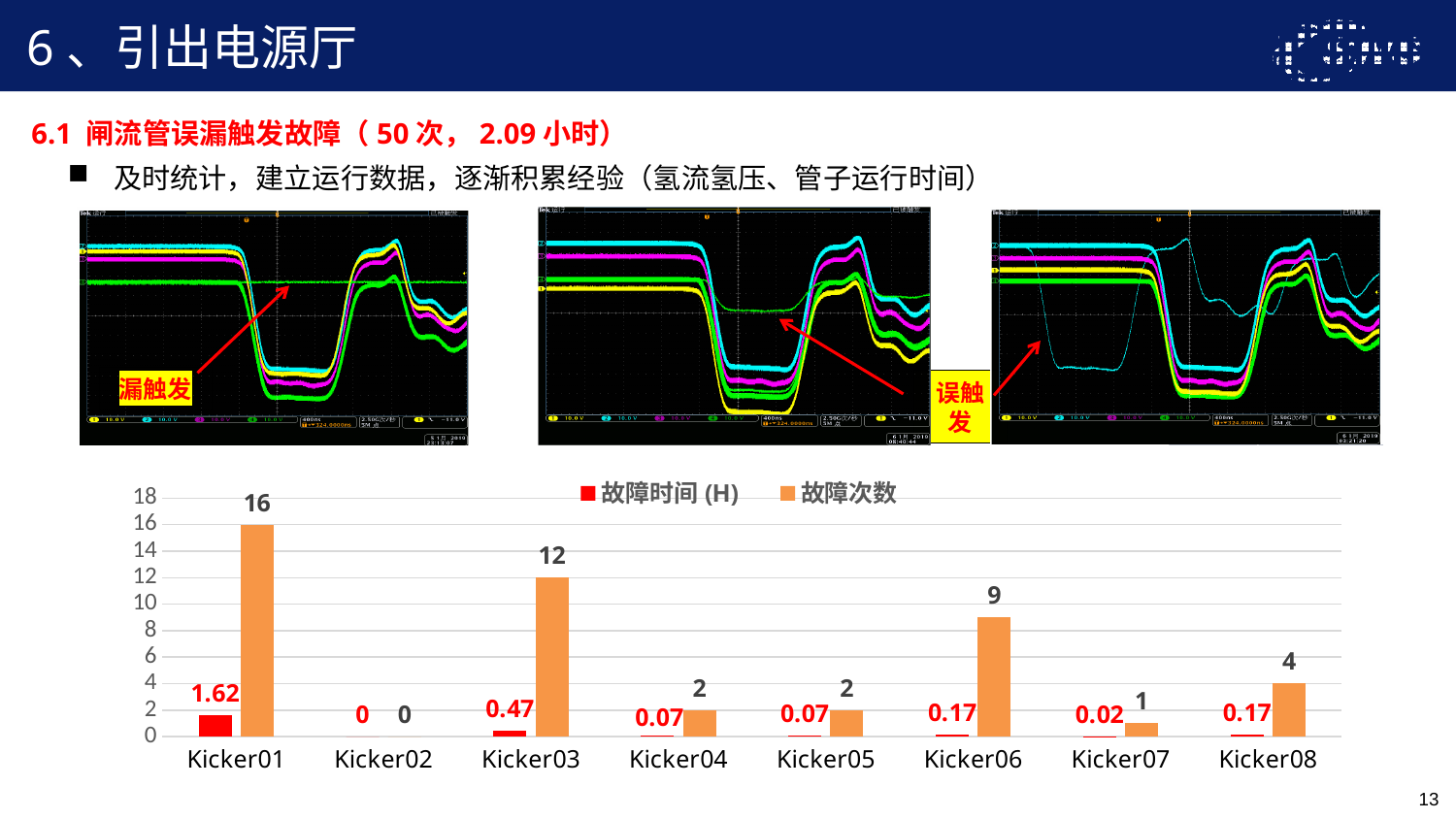
How many Kicker categories are shown on the x axis of the bar chart? 8 What is the 故障次数 value for Kicker01? 16 Which Kicker has the highest 故障次数? Kicker01 What is the 故障时间 (H) value for Kicker07? 0.02 Which Kicker has the highest 故障时间 (H)? Kicker01 What is the difference in 故障次数 between Kicker01 and Kicker03? 4 How many series does the legend of the bar chart list? 2 What colour are the 故障次数 bars in the chart? Orange What type of chart is shown at the bottom of the slide? Bar chart Which has a larger 故障次数, Kicker06 or Kicker08? Kicker06 What is the 故障次数 value for Kicker06? 9 What is the 故障时间 (H) value for Kicker03? 0.47